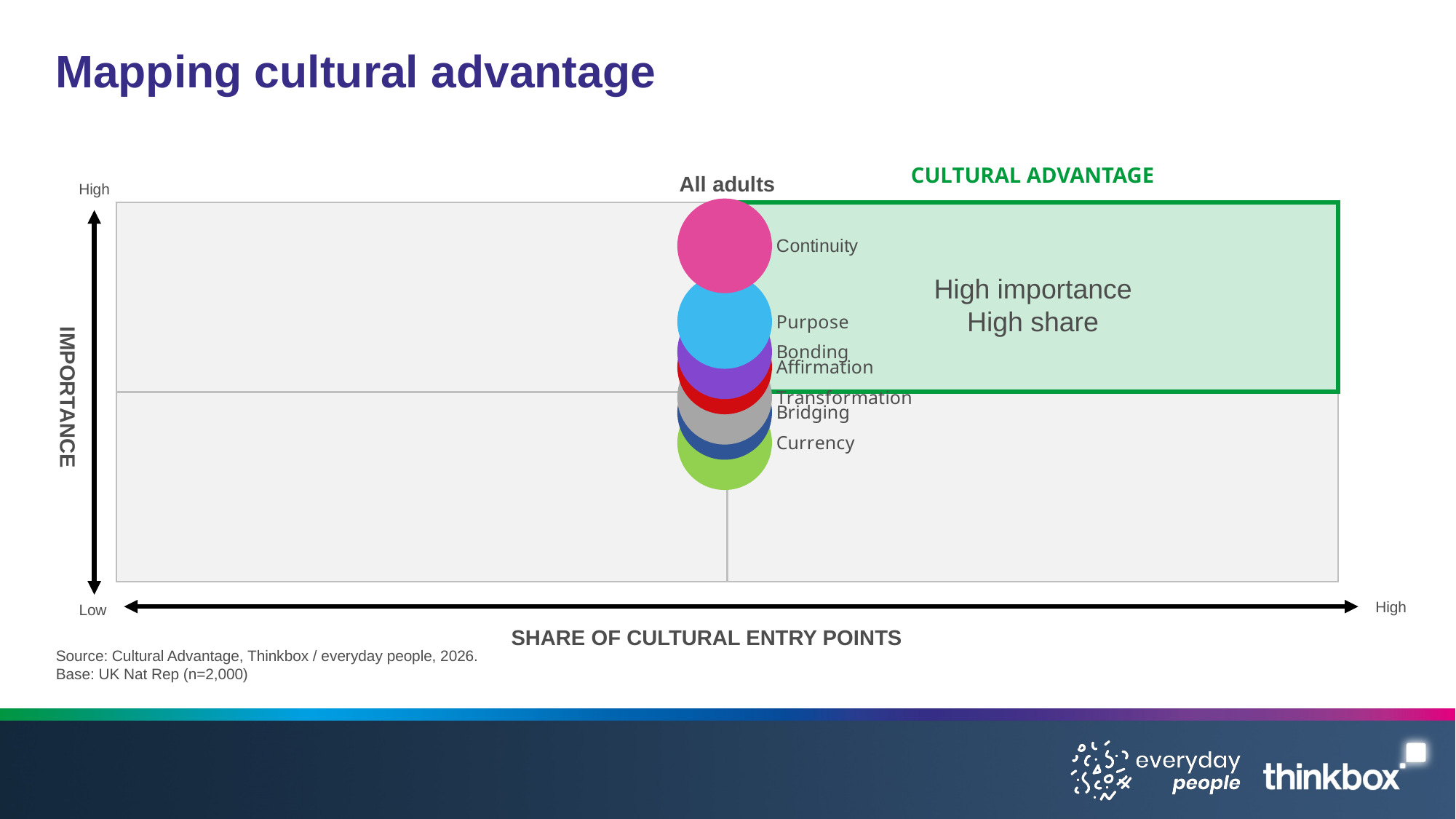
Which is plotted higher on the Importance axis, Continuity or Purpose? Continuity Which is plotted higher on the Importance axis, Purpose or Currency? Purpose Which category is plotted highest on the Importance axis? Continuity What label is given to the highlighted green quadrant in the top right of the chart? CULTURAL ADVANTAGE How many bubbles (categories) are plotted on the chart? 7 Which category is plotted lowest on the Importance axis? Currency What is the label of the horizontal axis of the chart? SHARE OF CULTURAL ENTRY POINTS What kind of chart is shown on the slide? Bubble chart Which is plotted higher on the Importance axis, Continuity or Currency? Continuity